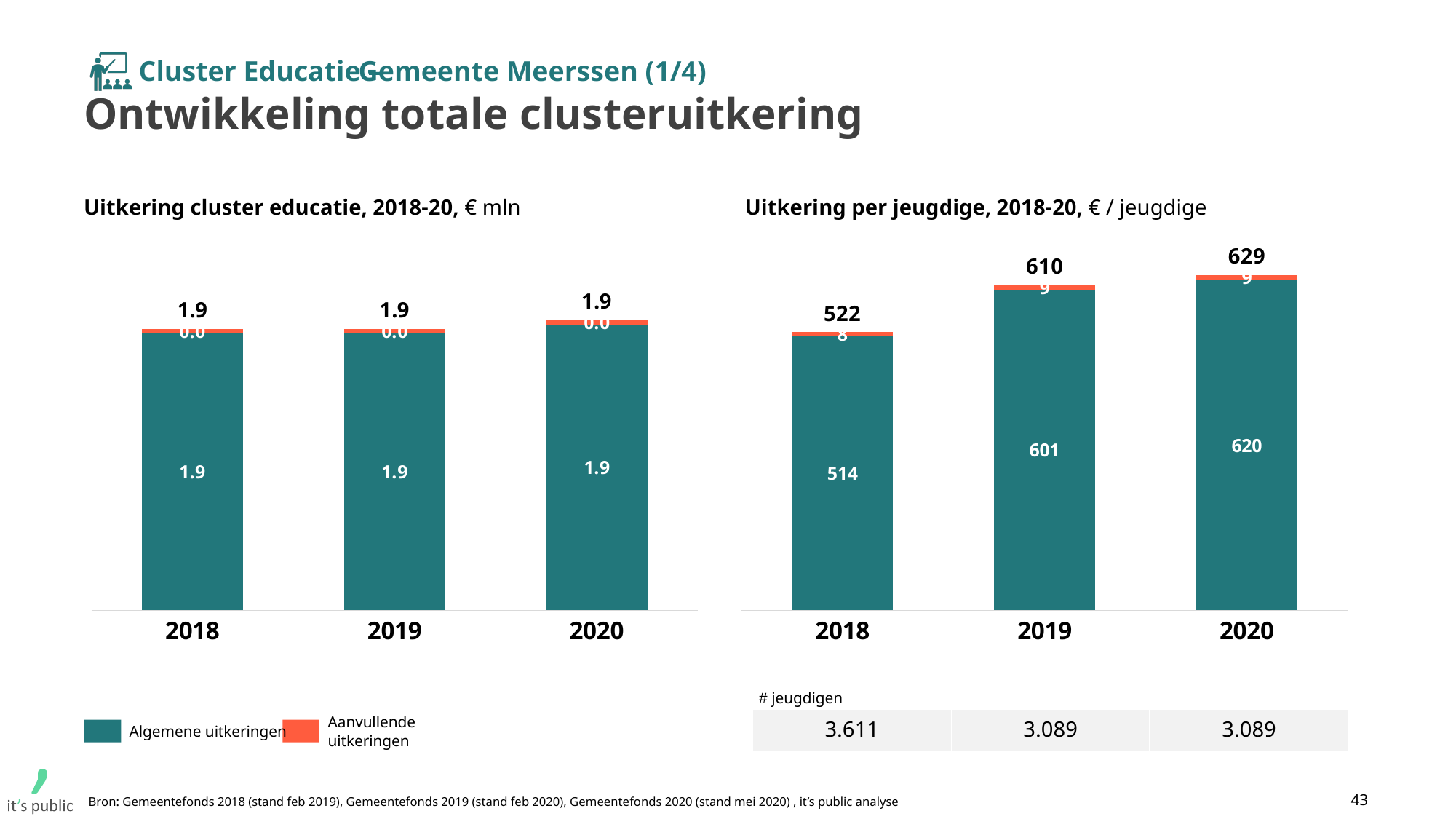
How many years are shown on the x axis of the chart 'Uitkering cluster educatie, 2018-20'? 3 What kind of chart is 'Uitkering per jeugdige, 2018-20'? Stacked bar chart In the chart 'Uitkering per jeugdige, 2018-20', which year has the highest total? 2020 In the chart 'Uitkering per jeugdige, 2018-20', what is the value of Algemene uitkeringen for 2019? 601 In the chart 'Uitkering per jeugdige, 2018-20', do the totals rise or fall from 2018 to 2020? Rise How many series does the legend list for the charts on this slide? 2 In the chart 'Uitkering per jeugdige, 2018-20', what is the total value for 2020? 629 In the chart 'Uitkering per jeugdige, 2018-20', which year has the lowest total? 2018 In the chart 'Uitkering per jeugdige, 2018-20', is the Algemene uitkeringen value larger in 2019 or in 2020? 2020 In the chart 'Uitkering per jeugdige, 2018-20', what is the value of Aanvullende uitkeringen for 2018? 8 In the chart 'Uitkering per jeugdige, 2018-20', what is the difference between the total for 2020 and the total for 2018? 107 In the chart 'Uitkering cluster educatie, 2018-20', what is the value of Algemene uitkeringen for 2020? 1.9